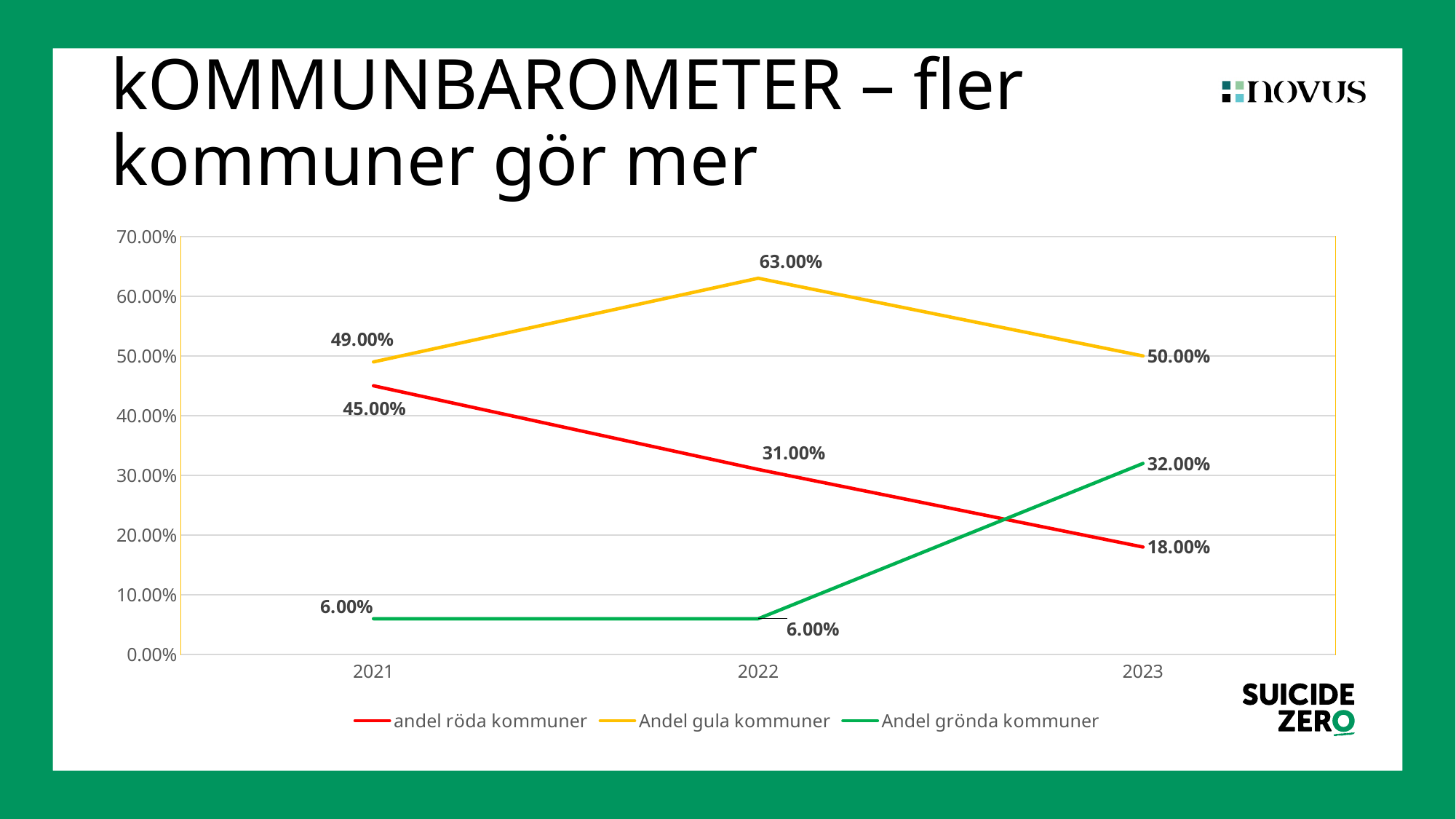
How many years are shown on the x axis? 3 What is the value for 'andel röda kommuner' in 2023? 18.00% What is the difference between 'andel röda kommuner' in 2021 and in 2023? 27.00% How many series does the legend list? 3 What is the value for 'Andel grönda kommuner' in 2021? 6.00% In which year is 'Andel gula kommuner' highest? 2022 In which year is 'andel röda kommuner' lowest? 2023 What colour is the line for 'Andel gula kommuner'? Yellow Does 'andel röda kommuner' rise or fall from 2021 to 2023? Fall What is the value for 'Andel gula kommuner' in 2022? 63.00% Which is larger in 2023: 'Andel grönda kommuner' or 'andel röda kommuner'? Andel grönda kommuner What type of chart is shown on the slide? Line chart